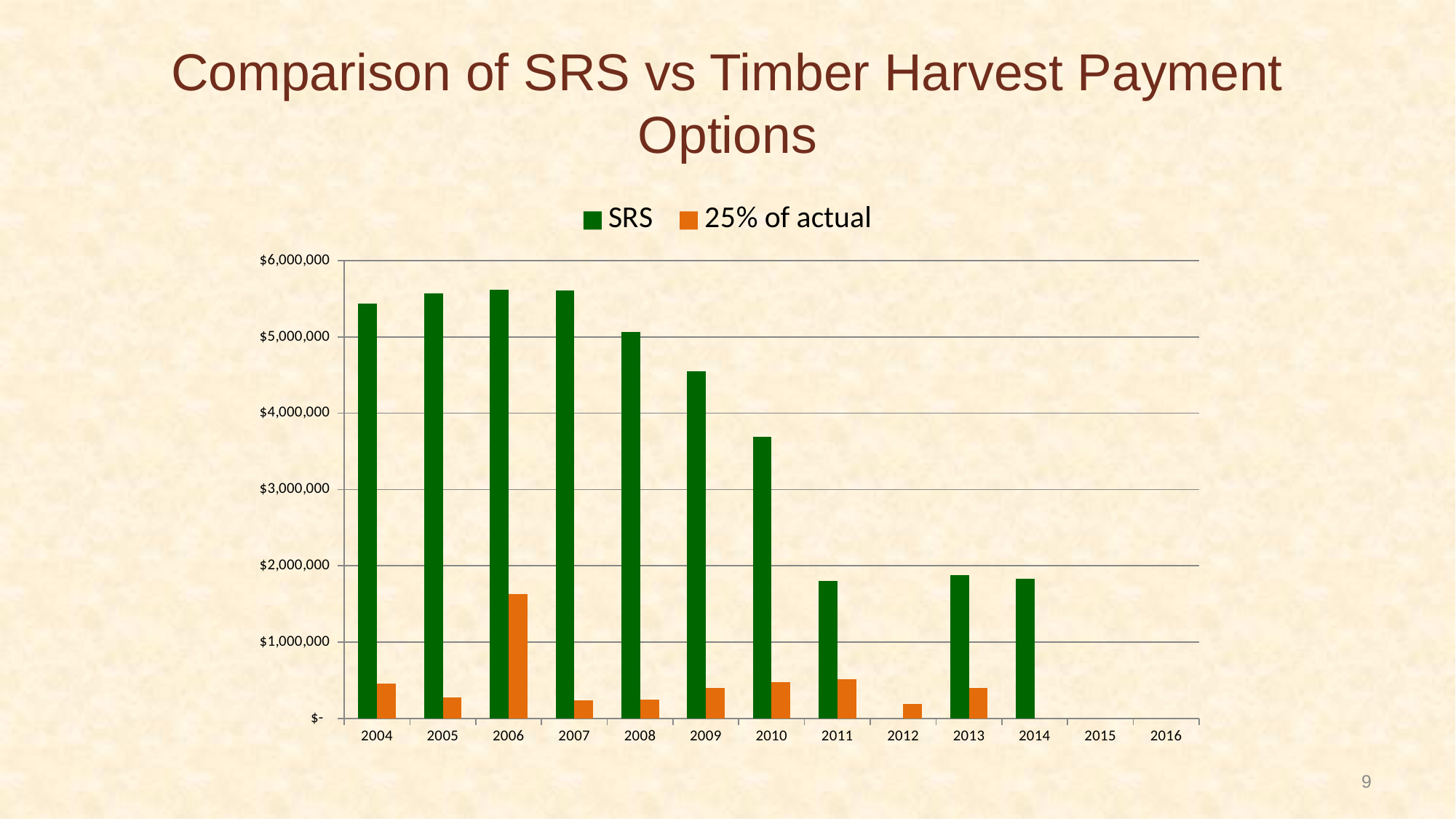
How many series does the legend list? 2 What colour are the SRS bars? Green Is the 25% of actual value for 2006 greater or less than $1,000,000? greater What kind of chart is shown on the slide? Bar chart In 2004, which series has the larger value, SRS or 25% of actual? SRS Do the SRS values rise or fall from 2007 to 2011? fall How many years are shown on the x axis? 13 Is the SRS value for 2010 greater or less than $3,000,000? greater Is the SRS value for 2011 greater or less than $2,000,000? less For the 25% of actual series, which year has the larger value, 2005 or 2006? 2006 Which year has the highest value for the 25% of actual series? 2006